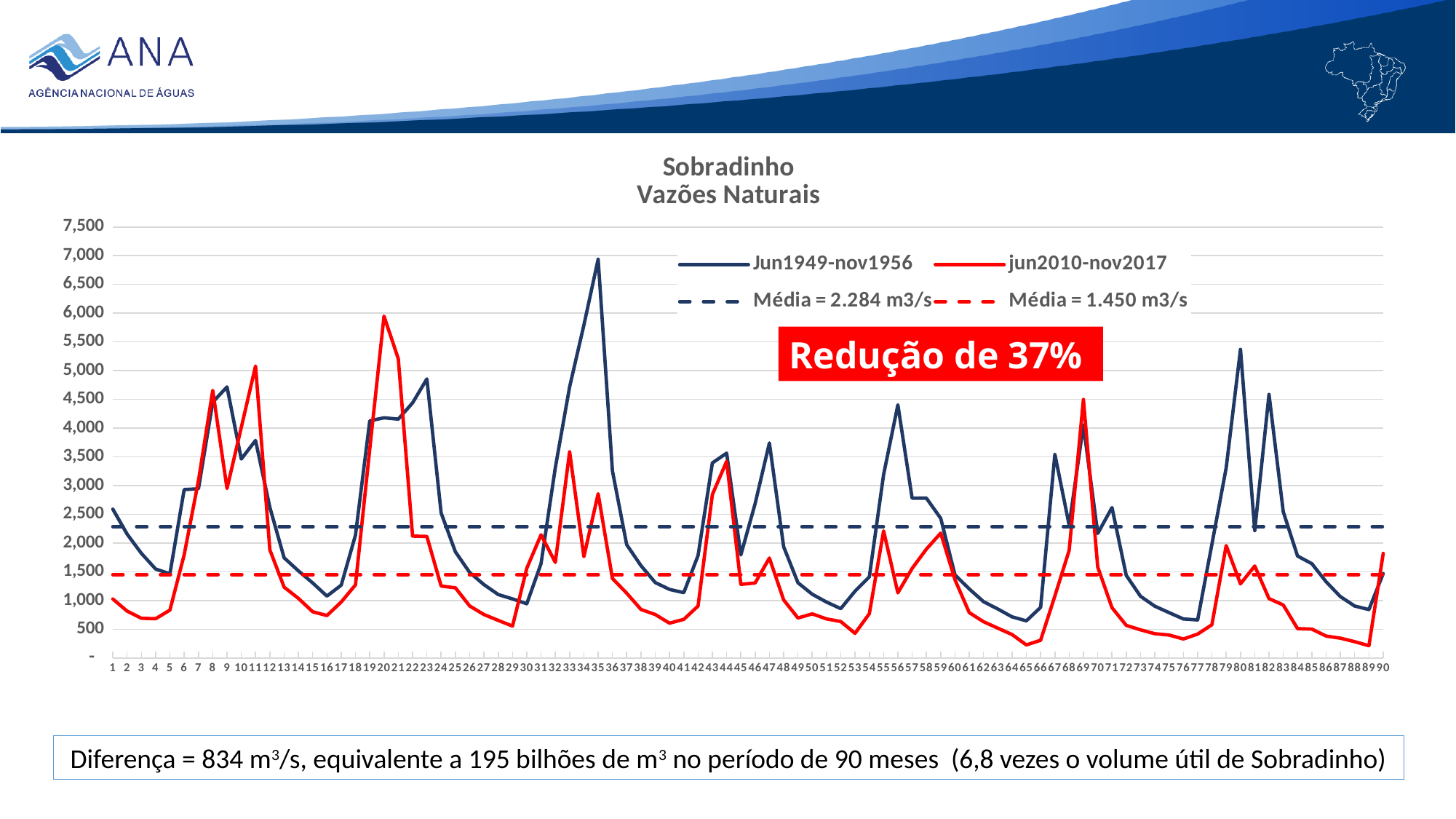
How many entries does the chart legend list? 4 Is the value for the Jun1949-nov1956 series at point 35 greater or less than 6,000? greater Is the value for the jun2010-nov2017 series at point 20 greater or less than 5,500? greater What kind of chart is shown on the slide? line chart What is the mean (Média) value shown for the Jun1949-nov1956 series? 2.284 m3/s What is the title of the chart? Sobradinho Vazões Naturais Which series has the larger mean value, Jun1949-nov1956 or jun2010-nov2017? Jun1949-nov1956 What is the difference between the two mean values shown in the legend? 834 m3/s How many points (months) are plotted along the x axis? 90 Which series reaches the highest peak value on the chart? Jun1949-nov1956 What is the mean (Média) value shown for the jun2010-nov2017 series? 1.450 m3/s Is the value for the jun2010-nov2017 series at point 89 greater or less than 500? less